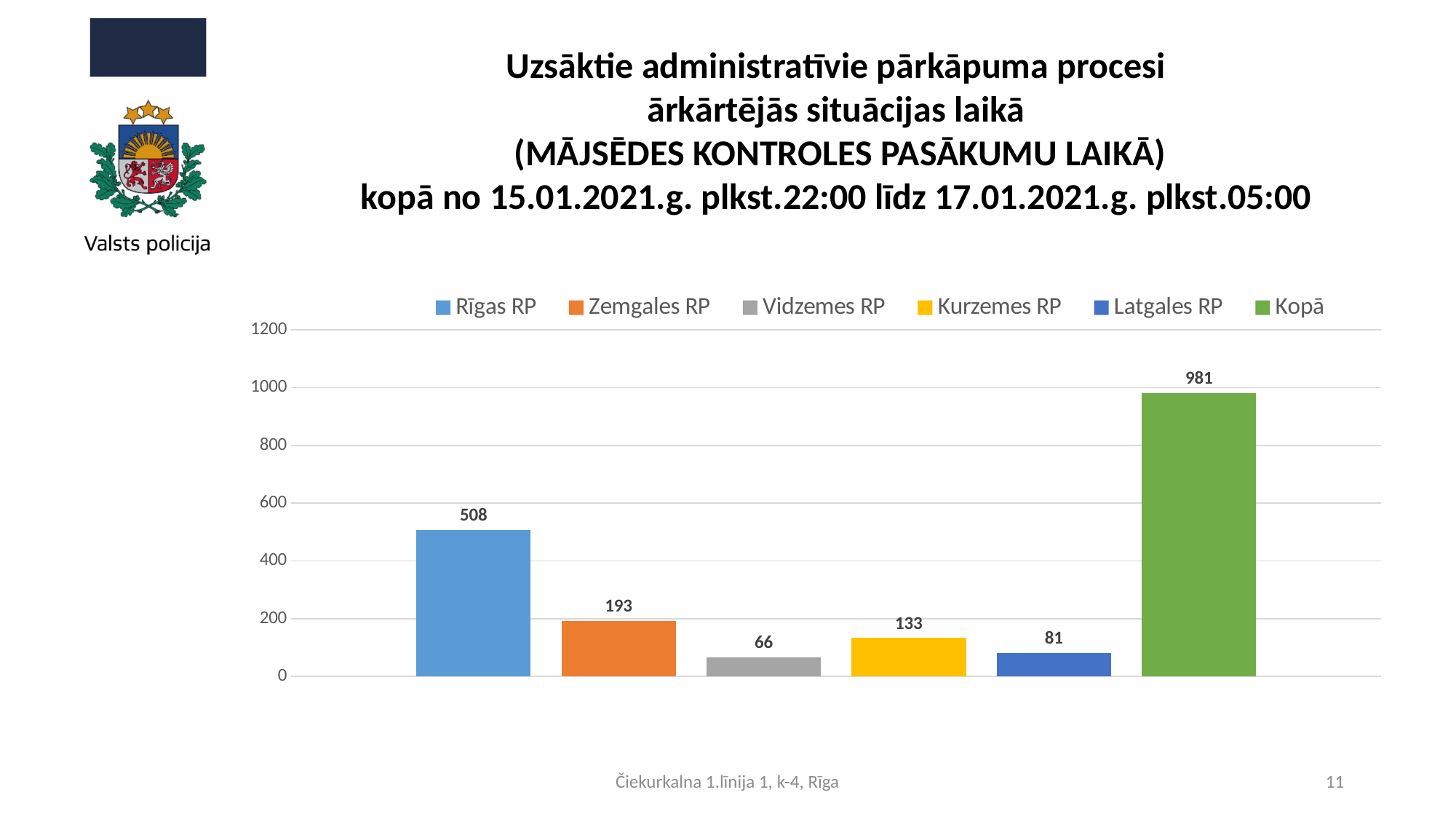
Which bar has the lowest value? Vidzemes RP What kind of chart is shown on the slide? bar chart How many entries does the legend list? 6 Is the value for Zemgales RP greater or less than 200? less What colour is the Kopā bar? green What is the value for Rīgas RP? 508 What is the value for Vidzemes RP? 66 What is the difference between the values for Zemgales RP and Kurzemes RP? 60 What is the value shown for Kopā? 981 How many bars are plotted in the chart? 6 Which regional police (RP) has the highest value? Rīgas RP Which is larger, the value for Kurzemes RP or Latgales RP? Kurzemes RP